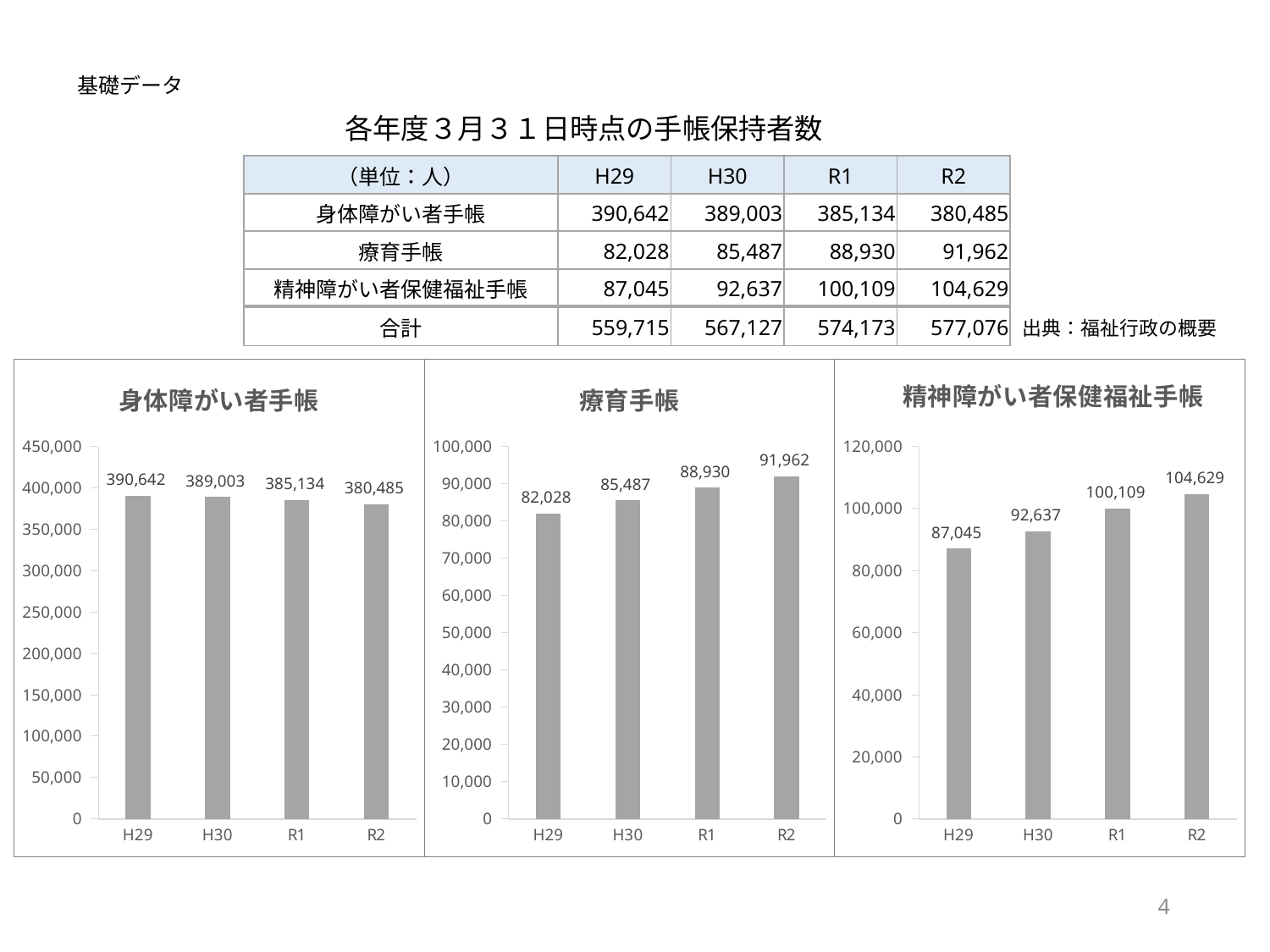
In the 身体障がい者手帳 chart, which is larger, the value for H30 or the value for R1? H30 In the 精神障がい者保健福祉手帳 chart, what is the difference between the R2 value and the R1 value? 4,520 In the 身体障がい者手帳 chart, what is the value for H29? 390,642 In the 精神障がい者保健福祉手帳 chart, what is the value for R1? 100,109 In the 療育手帳 chart, what is the value for R2? 91,962 In the 精神障がい者保健福祉手帳 chart, which year has the highest value? R2 In the 療育手帳 chart, what is the difference between the R2 value and the H29 value? 9,934 What kind of chart is the 精神障がい者保健福祉手帳 chart? bar chart In the 身体障がい者手帳 chart, do the values rise or fall from H29 to R2? fall In the 身体障がい者手帳 chart, which year has the lowest value? R2 In the 療育手帳 chart, is the value for H29 greater or less than 90,000? less How many bars are in the 療育手帳 chart? 4